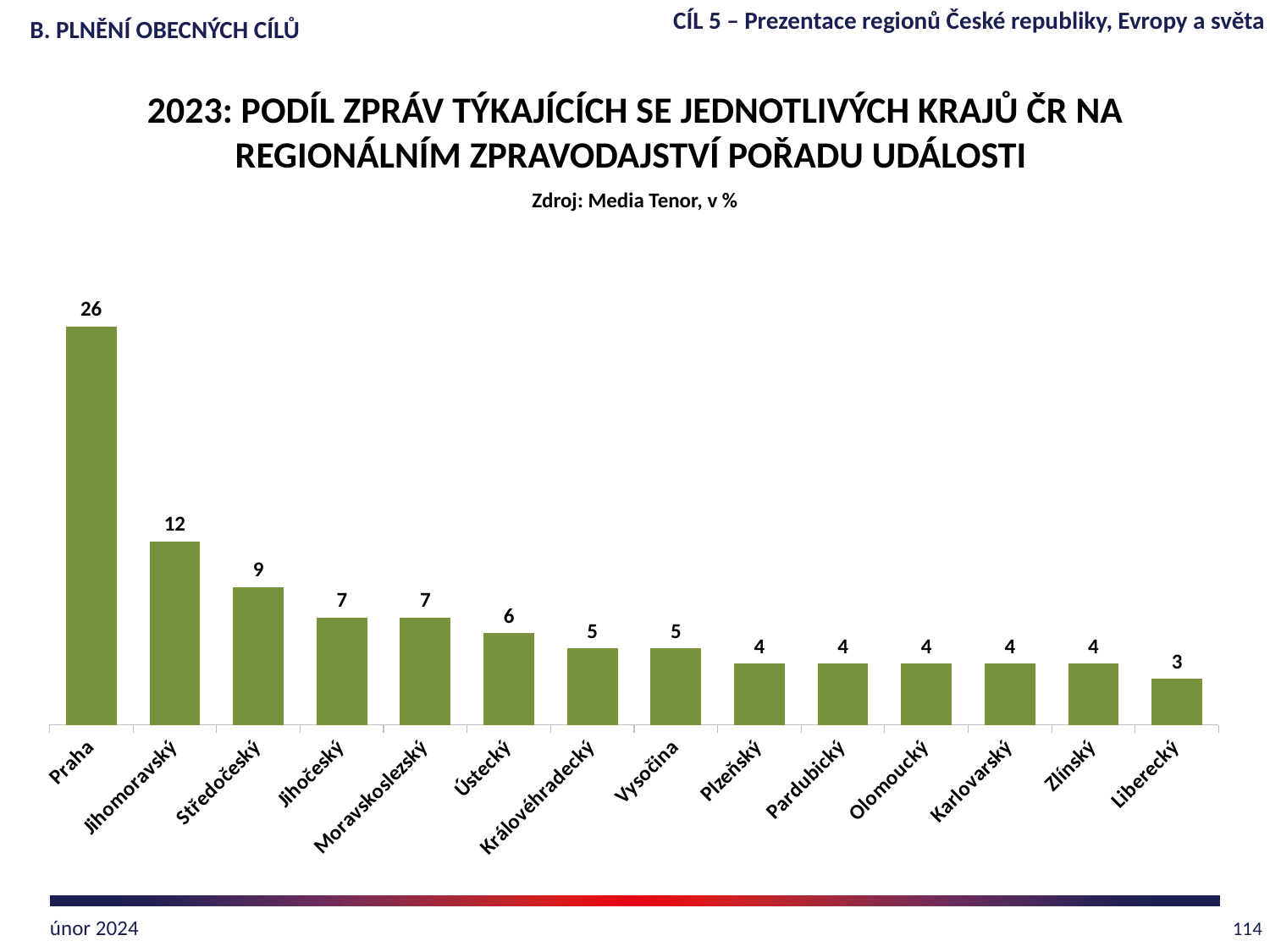
Do the values rise or fall from left to right along the x axis? fall How many regions are shown on the chart? 14 Which is larger, the value for Ústecký or the value for Vysočina? Ústecký What is the value for Praha? 26 What is the value for Jihomoravský? 12 What is the difference between the values for Praha and Jihomoravský? 14 What is the value for Liberecký? 3 What source is given for the chart data? Media Tenor Which region has the lowest value? Liberecký What kind of chart is this? bar chart Which region has the highest value? Praha What is the value for Středočeský? 9